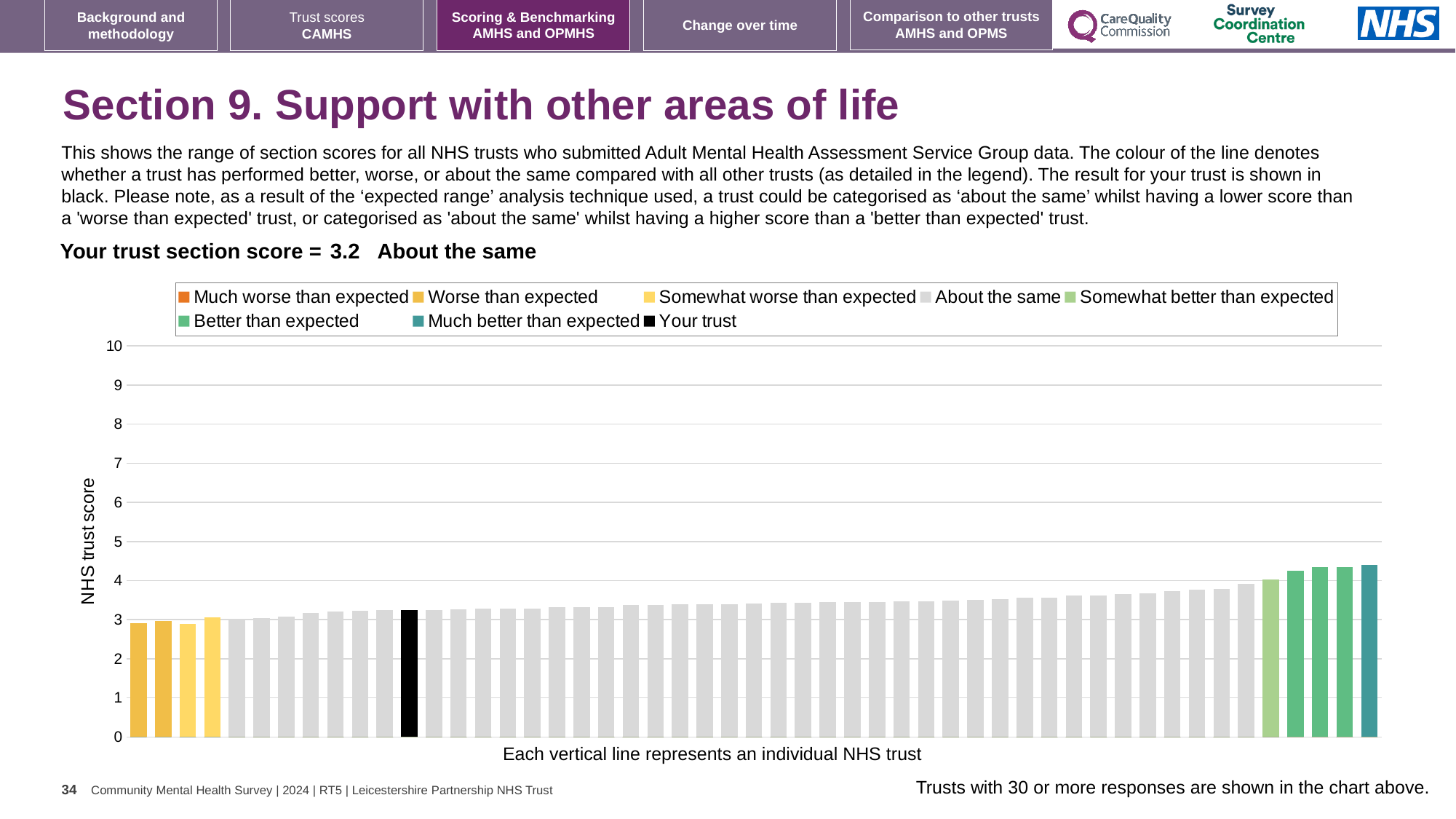
What is your trust's section score for Section 9, Support with other areas of life? 3.2 What is the title of the vertical axis of the chart? NHS trust score Is the value of the tallest bar in the chart greater or less than 4? greater How many entries does the chart legend list? 8 Do the bar values rise or fall from left to right along the x axis? Rise Is the value of the black 'Your trust' bar greater or less than 4? less Is the value of the tallest bar in the chart greater or less than 5? less What kind of chart is shown on the slide? Bar chart Which category does your trust's section score fall into? About the same Which legend category does the tallest bar in the chart belong to? Much better than expected